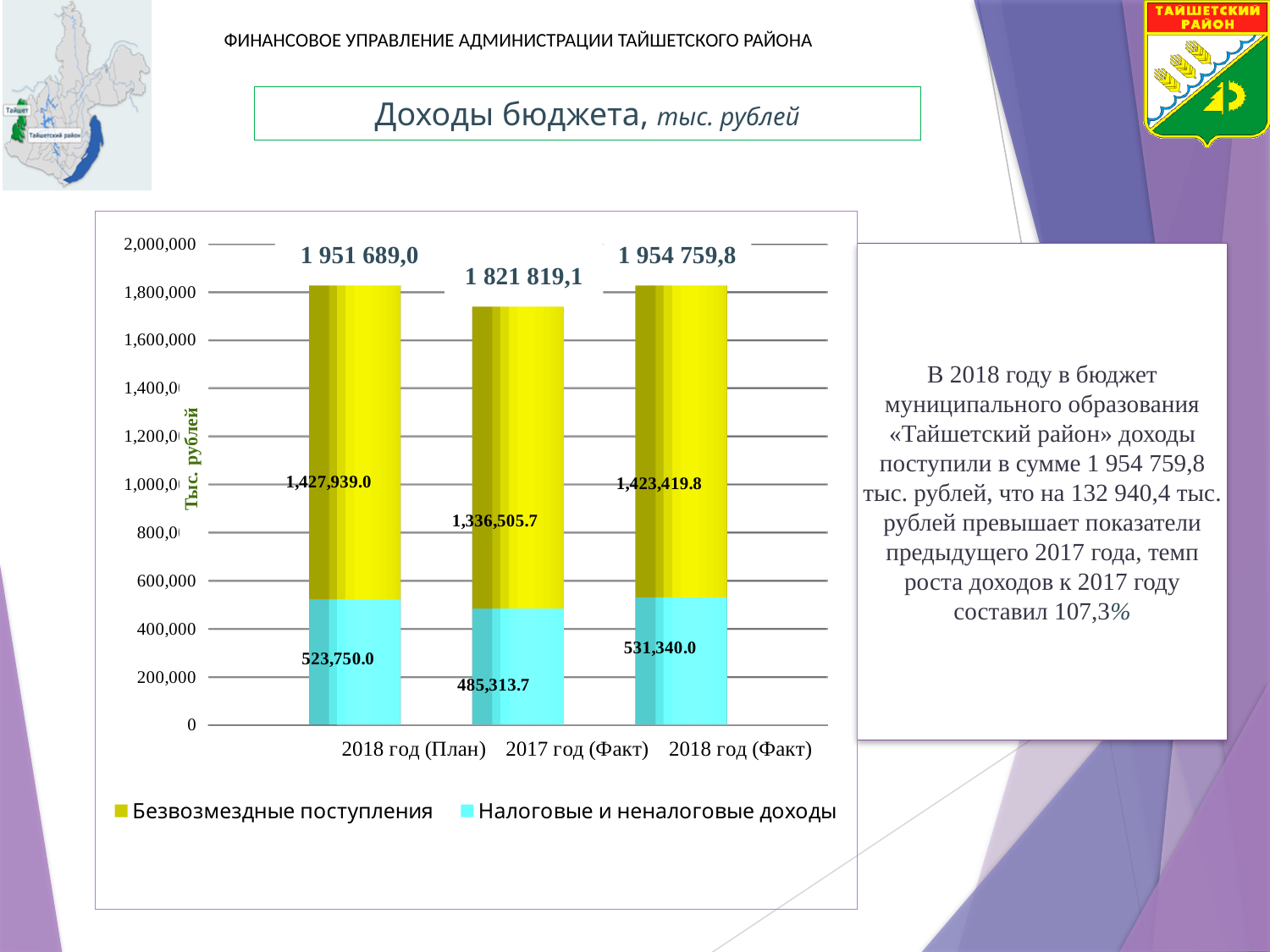
What is the value of Налоговые и неналоговые доходы for 2018 год (Факт)? 531,340.0 Which category has the highest value for Безвозмездные поступления? 2018 год (План) What is the total shown above the bar for 2018 год (Факт)? 1 954 759,8 What is the value of Налоговые и неналоговые доходы for 2017 год (Факт)? 485,313.7 Which is larger: Налоговые и неналоговые доходы for 2018 год (План) or for 2017 год (Факт)? 2018 год (План) How many series does the chart legend list? 2 What kind of chart is shown on the slide? stacked bar chart How many categories are shown on the x axis of the chart? 3 Which category has the lowest value for Налоговые и неналоговые доходы? 2017 год (Факт) What is the value of Безвозмездные поступления for 2017 год (Факт)? 1,336,505.7 What is the title of the chart on the slide? Доходы бюджета, тыс. рублей What is the value of Безвозмездные поступления for 2018 год (План)? 1,427,939.0